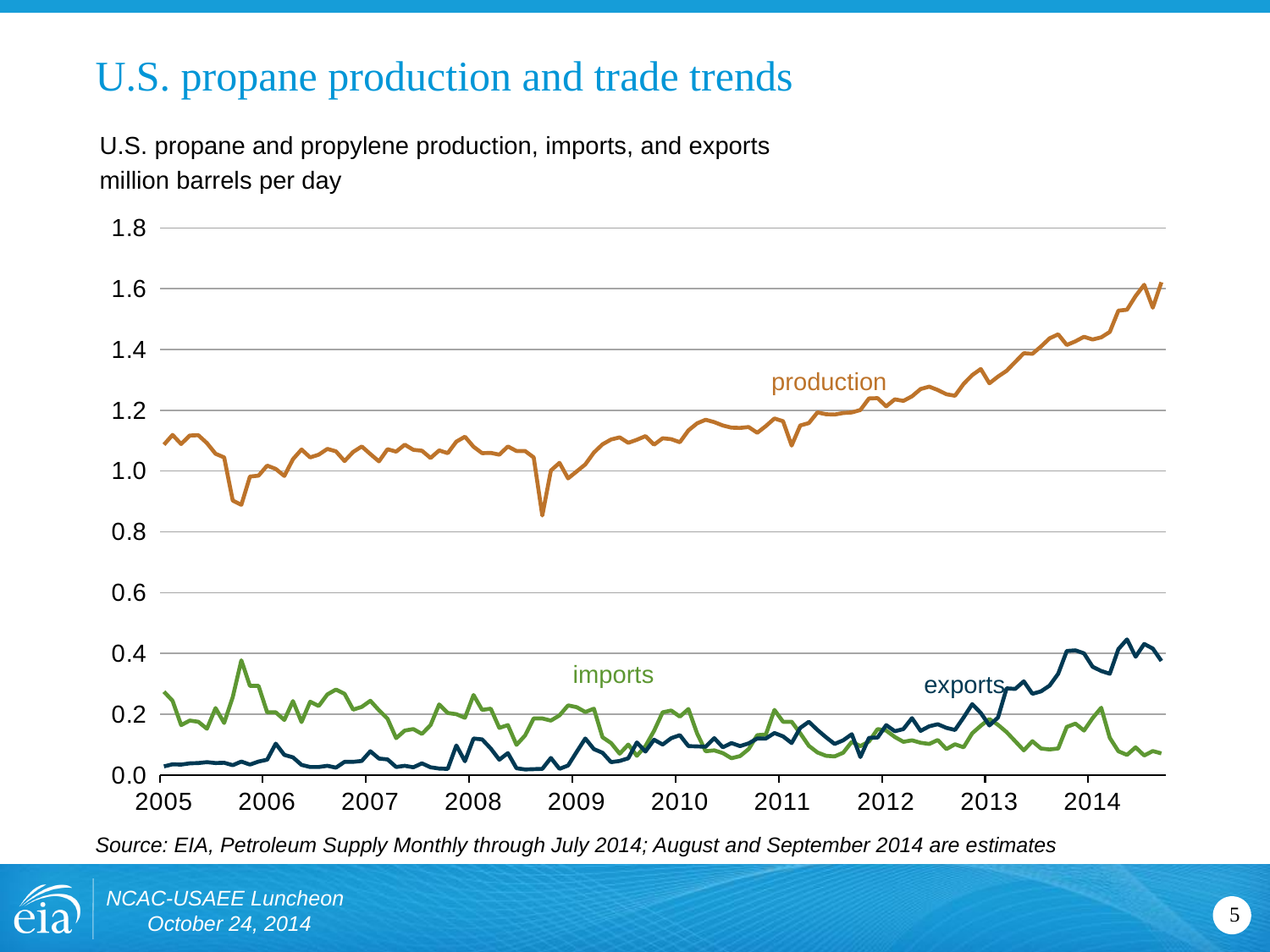
How many data series are plotted on the chart? 3 What are the three series labeled on the chart? production, imports, exports Which series has the highest values throughout the chart? production What kind of chart is shown on the slide? line chart Does the production series generally rise or fall from 2005 to 2014? rise Does the exports series generally rise or fall from 2005 to 2014? rise Is the value for imports at the end of 2014 greater or less than 0.4? less Is the value for production in 2014 greater or less than 1.4? greater What unit is the chart measured in, according to the subtitle? million barrels per day Is the value for exports at the start of 2005 greater or less than 0.2? less In 2014, which is larger, exports or imports? exports